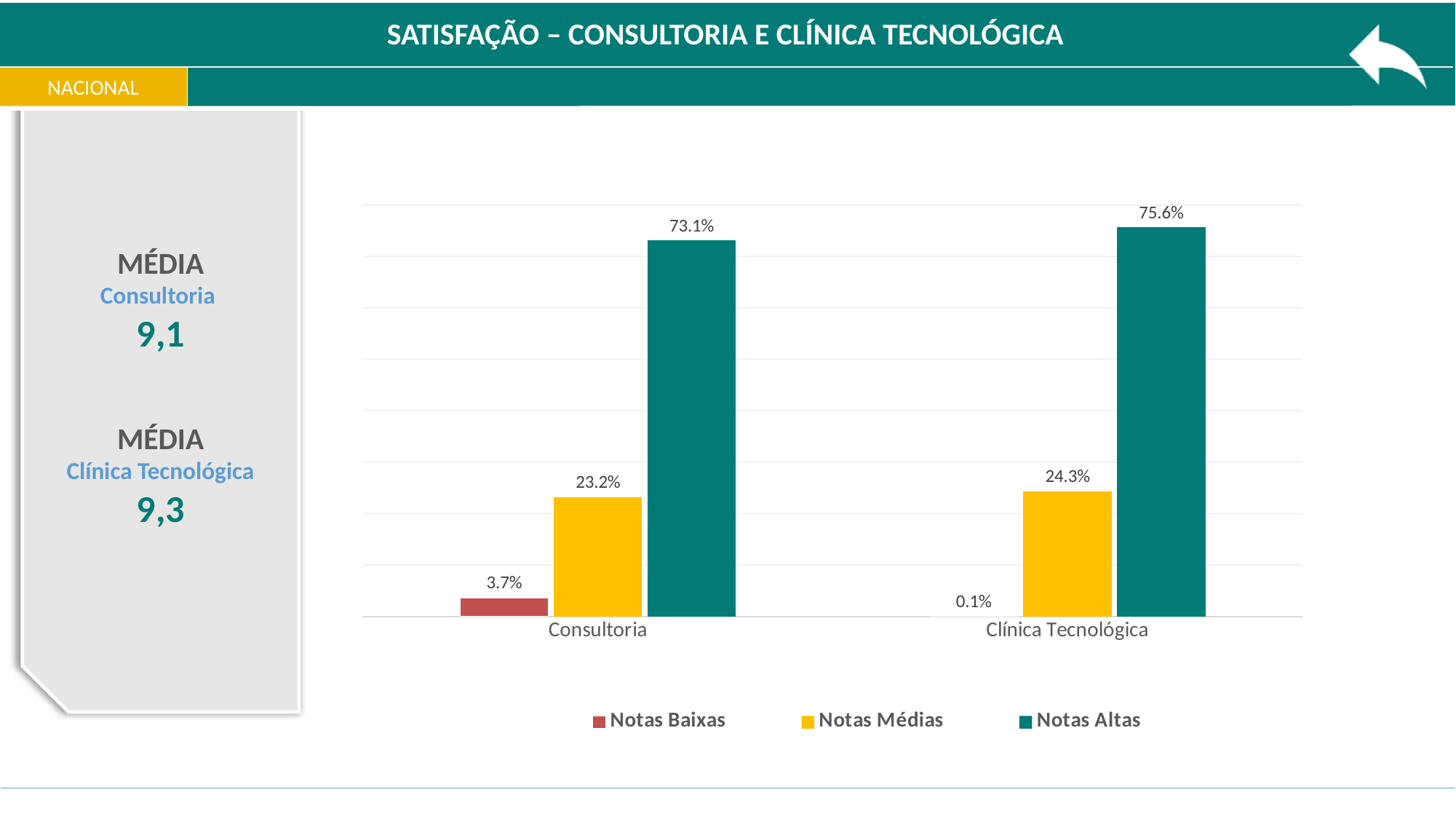
Which series has the lowest value for Consultoria? Notas Baixas How many categories are shown on the x axis? 2 What is the value of Notas Baixas for Clínica Tecnológica? 0.1% What colour are the Notas Médias bars? Yellow Which is larger: Notas Médias for Consultoria or Notas Médias for Clínica Tecnológica? Clínica Tecnológica What is the value of Notas Altas for Consultoria? 73.1% What is the value of Notas Médias for Clínica Tecnológica? 24.3% How many series does the legend list? 3 What is the value of Notas Baixas for Consultoria? 3.7% Which series has the highest value for Clínica Tecnológica? Notas Altas What is the difference between Notas Altas for Clínica Tecnológica and Notas Altas for Consultoria? 2.5% What kind of chart is shown on the slide? Bar chart